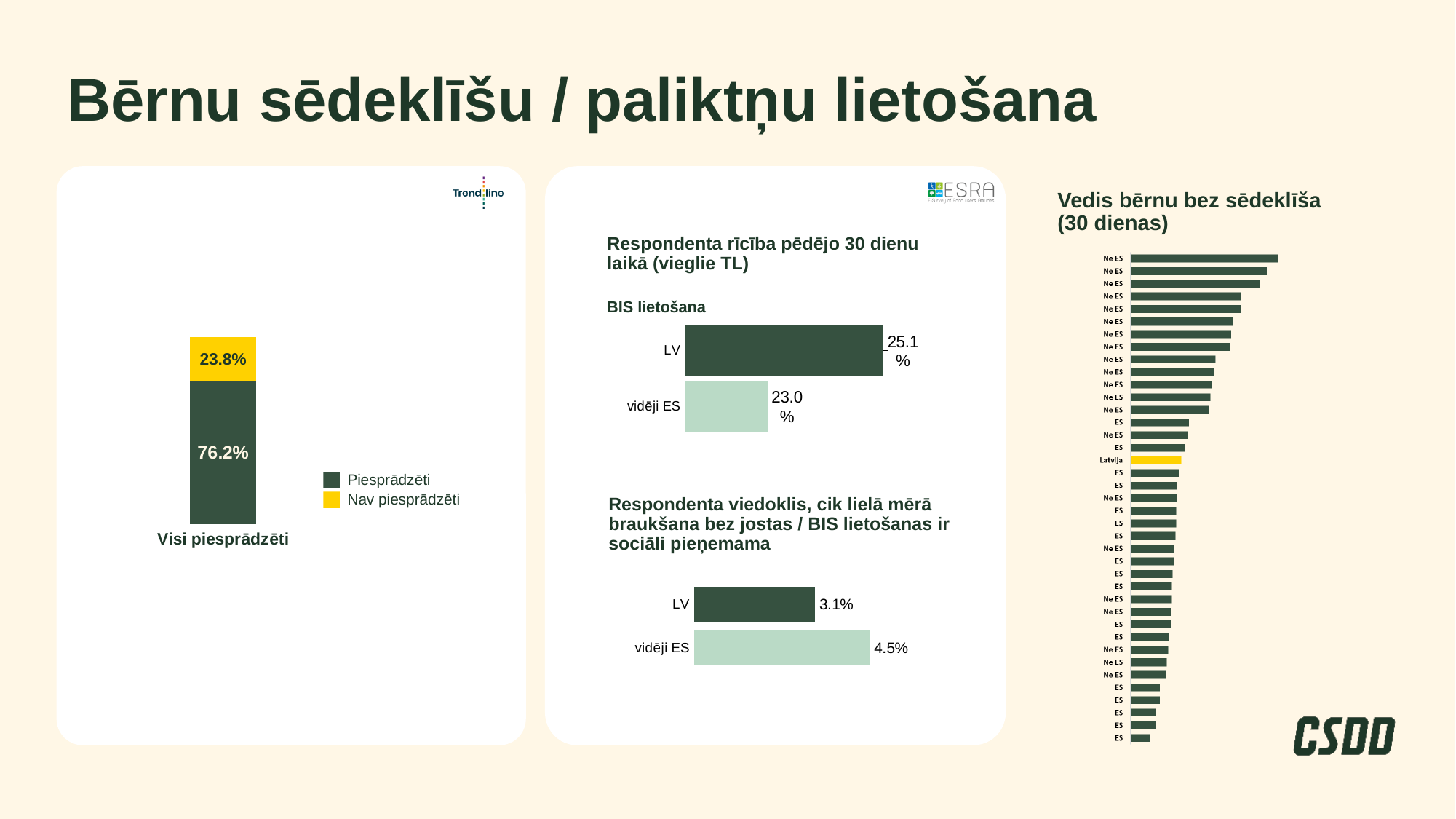
In the left chart titled 'Visi piesprādzēti', what is the value for 'Nav piesprādzēti'? 23.8% In the left chart titled 'Visi piesprādzēti', how many series does the legend list? 2 In the 'BIS lietošana' chart in the middle panel, what is the value for LV? 25.1% In the chart under 'Respondenta viedoklis, cik lielā mērā braukšana bez jostas / BIS lietošanas ir sociāli pieņemama', what is the value for LV? 3.1% In the right chart titled 'Vedis bērnu bez sēdeklīša (30 dienas)', which category's bar is highlighted in yellow? Latvija In the 'BIS lietošana' chart in the middle panel, which is larger, LV or vidēji ES? LV In the left chart titled 'Visi piesprādzēti', what is the value for 'Piesprādzēti'? 76.2% In the chart under 'Respondenta viedoklis, cik lielā mērā braukšana bez jostas / BIS lietošanas ir sociāli pieņemama', what is the value for 'vidēji ES'? 4.5% In the chart under 'Respondenta viedoklis, cik lielā mērā braukšana bez jostas / BIS lietošanas ir sociāli pieņemama', what is the difference between vidēji ES and LV? 1.4% In the 'BIS lietošana' chart in the middle panel, what is the value for 'vidēji ES'? 23.0% In the left chart titled 'Visi piesprādzēti', what is the total of the stacked bar? 100.0% In the 'BIS lietošana' chart in the middle panel, what is the difference between LV and vidēji ES? 2.1%